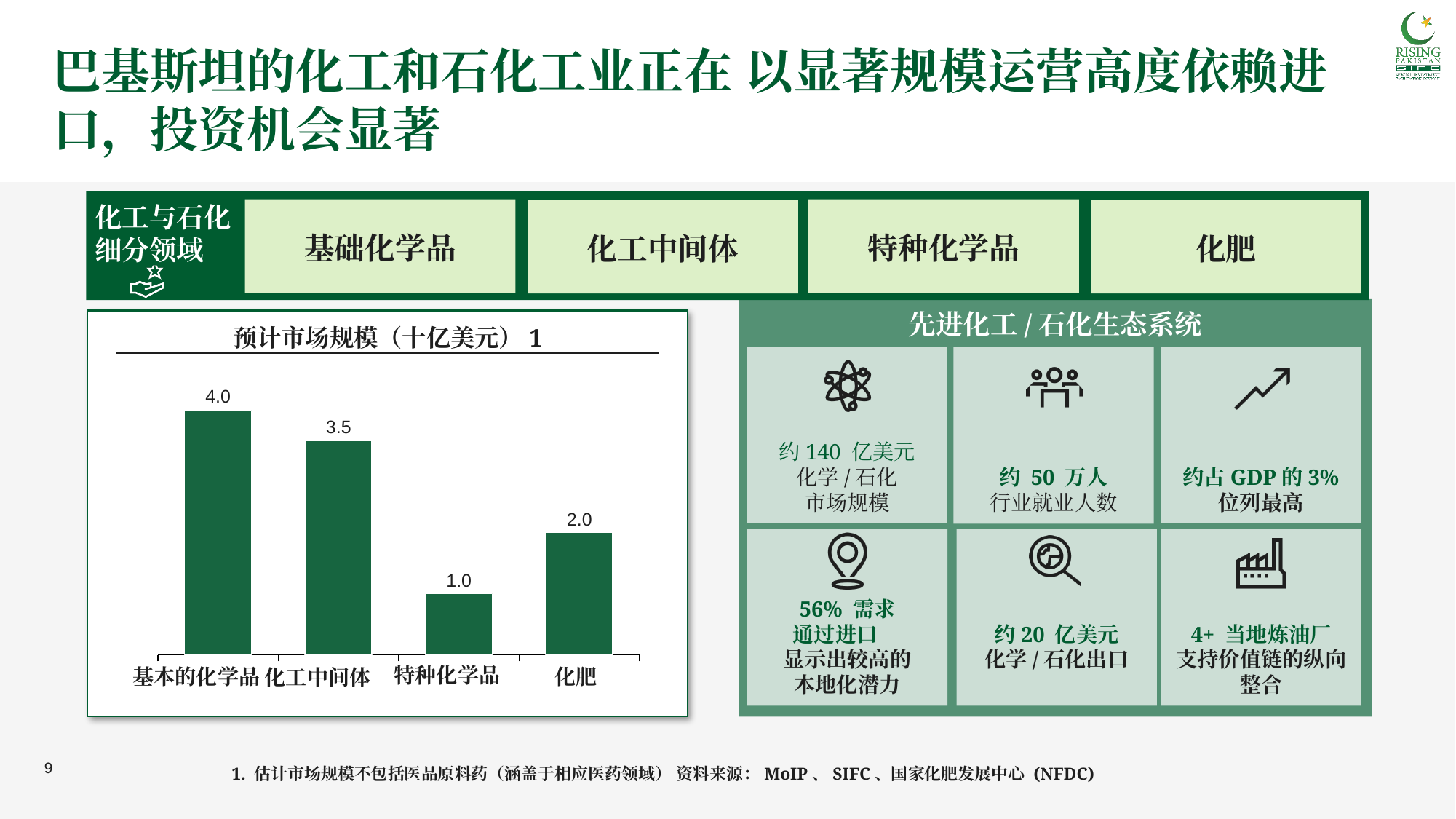
How many categories are shown in the chart? 4 What is the projected market size for 化工中间体? 3.5 Which category has the lowest projected market size? 特种化学品 What kind of chart is shown on the slide? bar chart What is the difference between the projected market size of 基本的化学品 and 化肥? 2.0 What is the difference between the projected market size of 化工中间体 and 特种化学品? 2.5 Which category has the highest projected market size? 基本的化学品 What is the projected market size for 特种化学品? 1.0 What is the projected market size for 基本的化学品 in the chart? 4.0 What is the projected market size for 化肥? 2.0 What is the title of the chart? 预计市场规模（十亿美元）1 Which has a larger projected market size, 化肥 or 特种化学品? 化肥